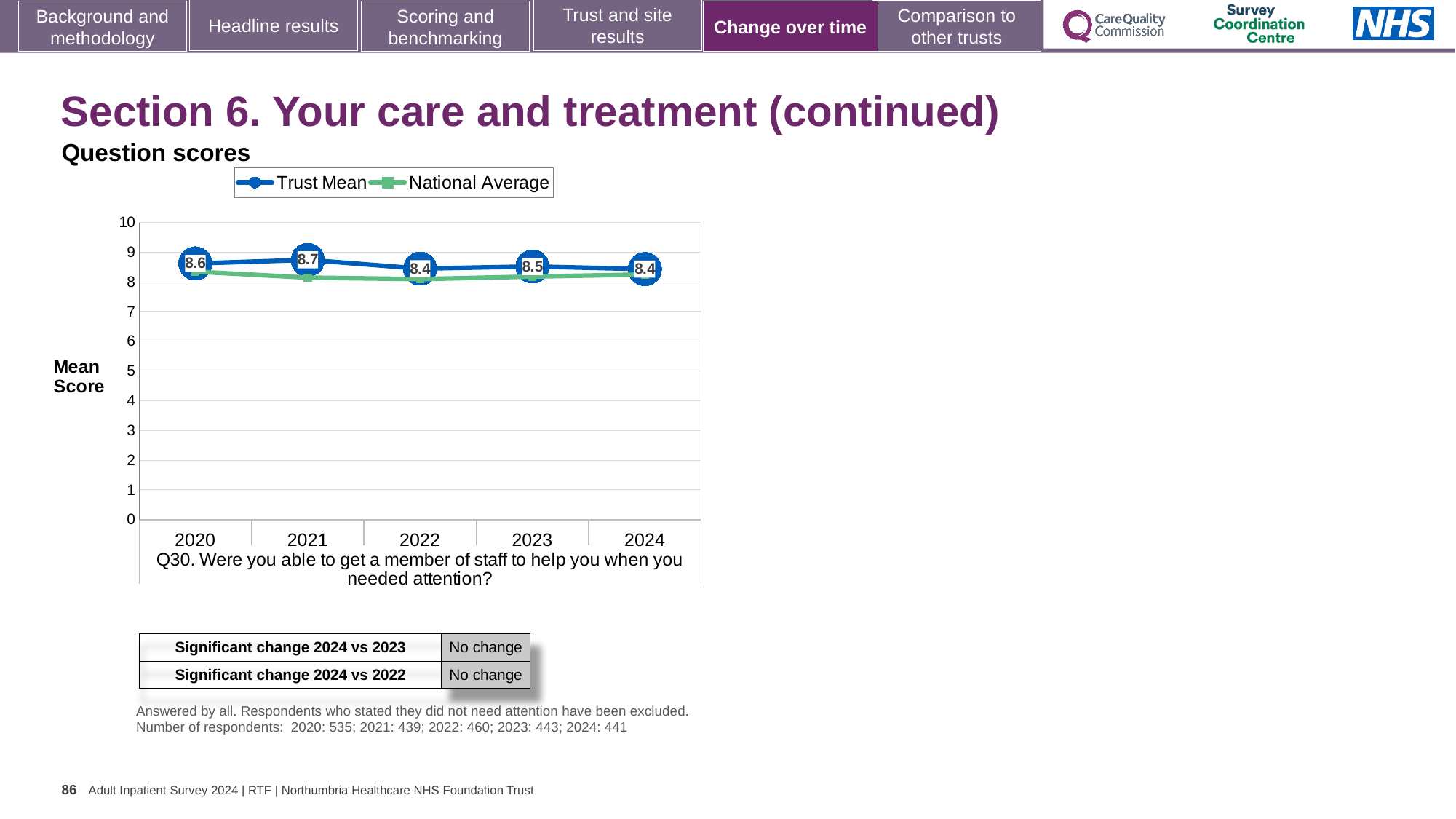
What kind of chart is shown on the slide? Line chart What is the label on the y axis of the chart? Mean Score Is the National Average value for 2022 greater or less than 9? less What is the Trust Mean score for 2021? 8.7 Which is larger, the Trust Mean score for 2020 or for 2023? 2020 In which year is the Trust Mean score highest? 2021 Is the National Average value for 2024 greater or less than 7? greater What is the Trust Mean score for 2020? 8.6 How many series does the legend list? 2 What is the Trust Mean score for 2024? 8.4 What is the difference between the Trust Mean scores for 2021 and 2022? 0.3 How many years are plotted on the x axis? 5